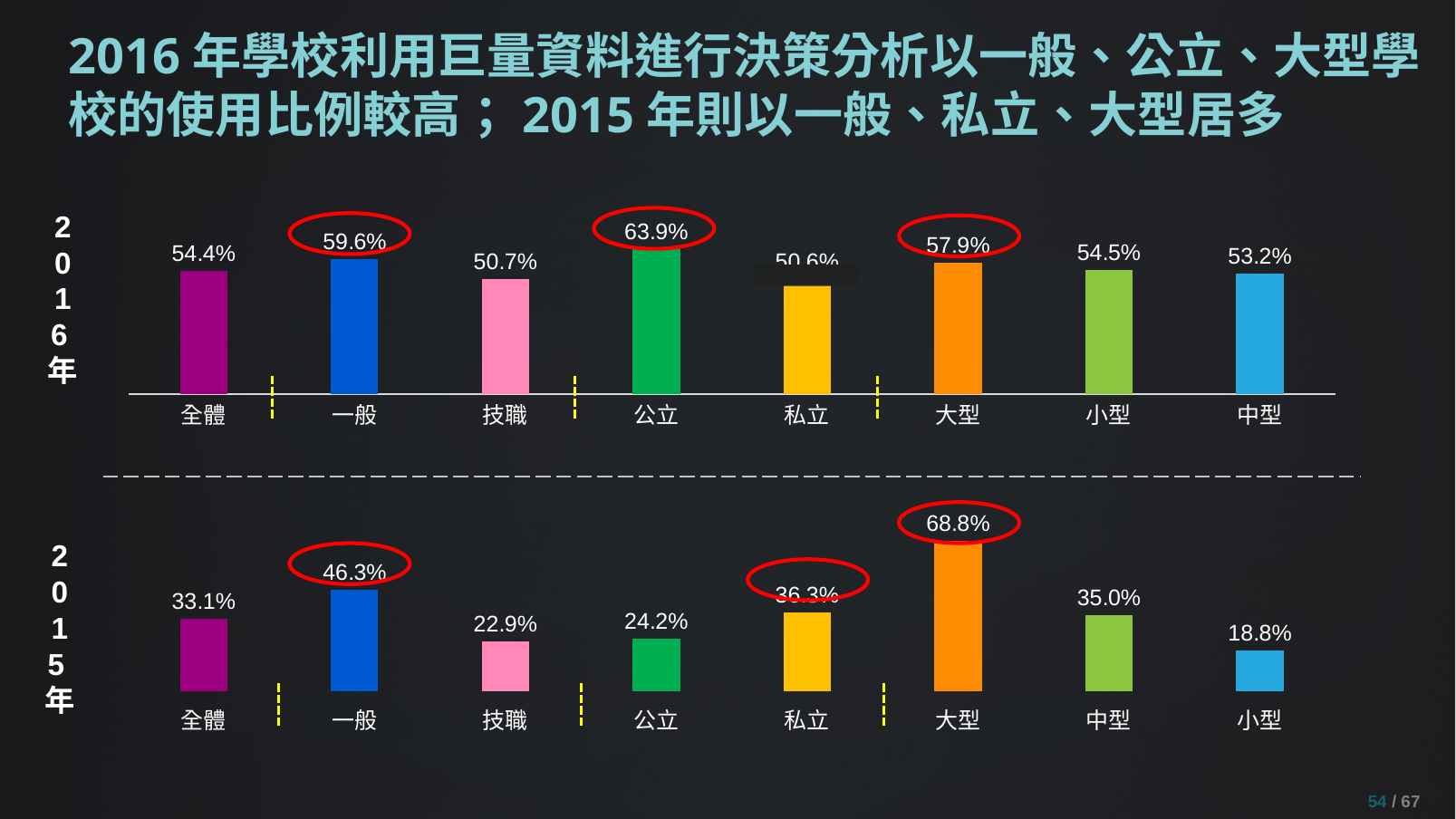
In the 2016年 chart, which category has the highest value? 公立 What kind of chart is the 2015年 chart? bar chart In the 2015年 chart, what is the value for 大型? 68.8% In the 2015年 chart, what is the difference between the values for 一般 and 技職? 23.4% In the 2015年 chart, what is the value for 小型? 18.8% In the 2016年 chart, what is the difference between the values for 公立 and 技職? 13.2% In the 2015年 chart, which category has the highest value? 大型 In the 2015年 chart, which is larger, the value for 中型 or the value for 公立? 中型 In the 2016年 chart, what is the value for 公立? 63.9% How many categories are shown in the 2016年 chart? 8 In the 2015年 chart, which category has the lowest value? 小型 In the 2016年 chart, what is the value for 一般? 59.6%